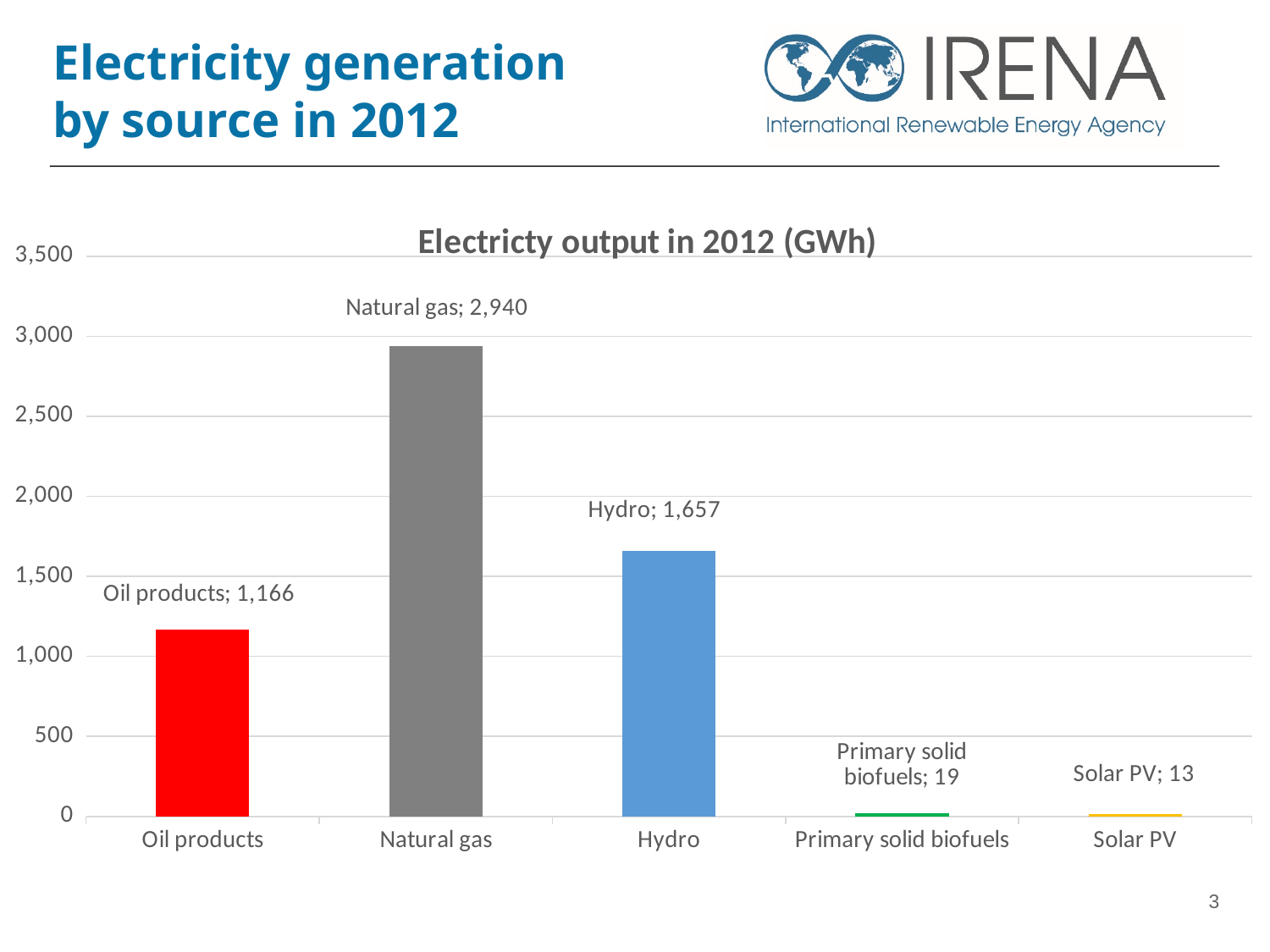
What is the electricity output for Hydro? 1,657 What is the electricity output for Solar PV? 13 What is the difference in electricity output between Natural gas and Hydro? 1,283 Is the value for Oil products greater or less than 1,000? greater What type of chart is shown on the slide? Bar chart Which source has the lowest electricity output? Solar PV How many sources are shown in the chart? 5 What is the difference in electricity output between Primary solid biofuels and Solar PV? 6 What is the electricity output for Oil products? 1,166 Which has a larger electricity output, Hydro or Oil products? Hydro What is the electricity output for Natural gas? 2,940 Which source has the highest electricity output? Natural gas